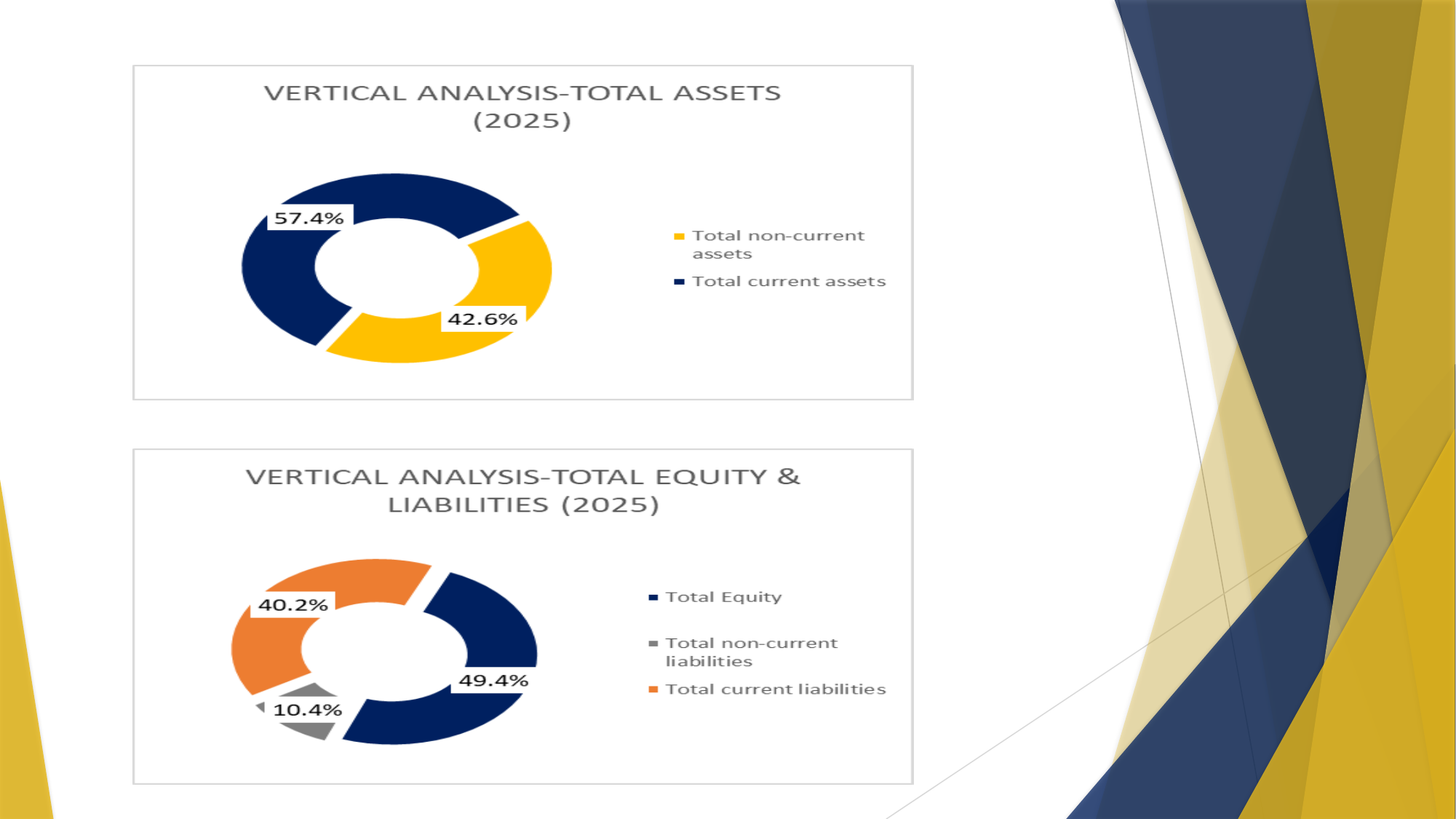
In the 'Vertical Analysis-Total Assets (2025)' chart, which category has the larger share? Total current assets What type of chart is the 'Vertical Analysis-Total Equity & Liabilities (2025)' chart? Doughnut (pie) chart How many entries does the legend of the 'Vertical Analysis-Total Assets (2025)' chart list? 2 In the 'Vertical Analysis-Total Equity & Liabilities (2025)' chart, which category has the smallest share? Total non-current liabilities In the 'Vertical Analysis-Total Equity & Liabilities (2025)' chart, what share is shown for Total non-current liabilities? 10.4% In the 'Vertical Analysis-Total Assets (2025)' chart, what share is shown for Total non-current assets? 42.6% In the 'Vertical Analysis-Total Assets (2025)' chart, what share is shown for Total current assets? 57.4% In the 'Vertical Analysis-Total Assets (2025)' chart, what is the difference in percentage points between Total current assets and Total non-current assets? 14.8 In the 'Vertical Analysis-Total Equity & Liabilities (2025)' chart, what share is shown for Total Equity? 49.4% In the 'Vertical Analysis-Total Equity & Liabilities (2025)' chart, which colour represents Total current liabilities? Orange In the 'Vertical Analysis-Total Equity & Liabilities (2025)' chart, how many categories are plotted? 3 In the 'Vertical Analysis-Total Equity & Liabilities (2025)' chart, what share is shown for Total current liabilities? 40.2%